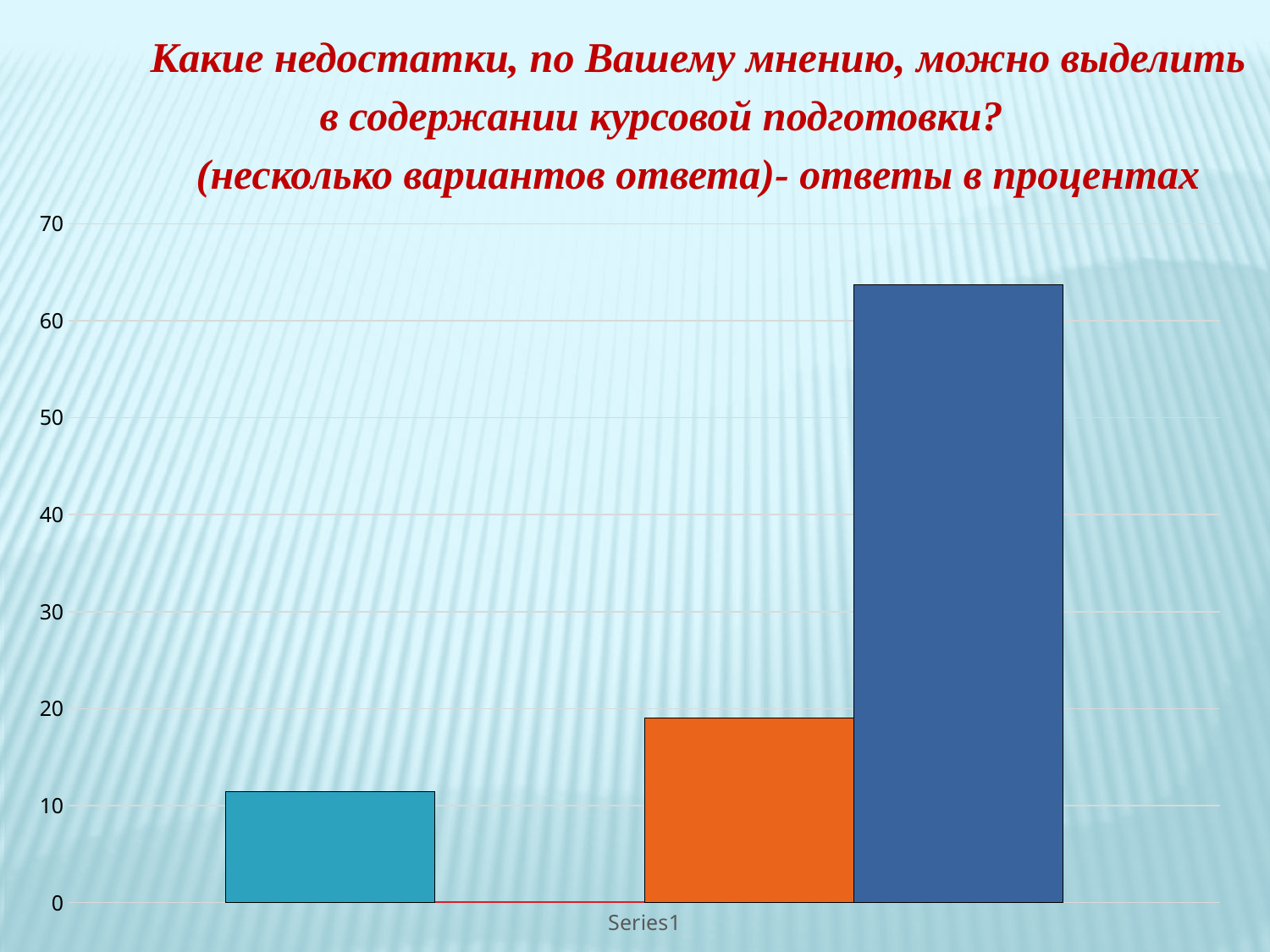
Which bar is the tallest in the chart? the dark blue bar (rightmost) Is the value of the orange (middle) bar greater or less than 20? less Is the value of the dark blue (rightmost) bar greater or less than 70? less What is the highest value shown on the vertical axis? 70 What label appears under the bars on the horizontal axis? Series1 Do the bar values rise or fall from left to right across the chart? rise Which of the three coloured bars is the shortest? the light blue bar (leftmost) Is the value of the light blue (leftmost) bar greater or less than 10? greater What kind of chart is shown on the slide? bar chart Which is larger, the dark blue bar or the orange bar? the dark blue bar Which is larger, the orange bar or the light blue bar? the orange bar